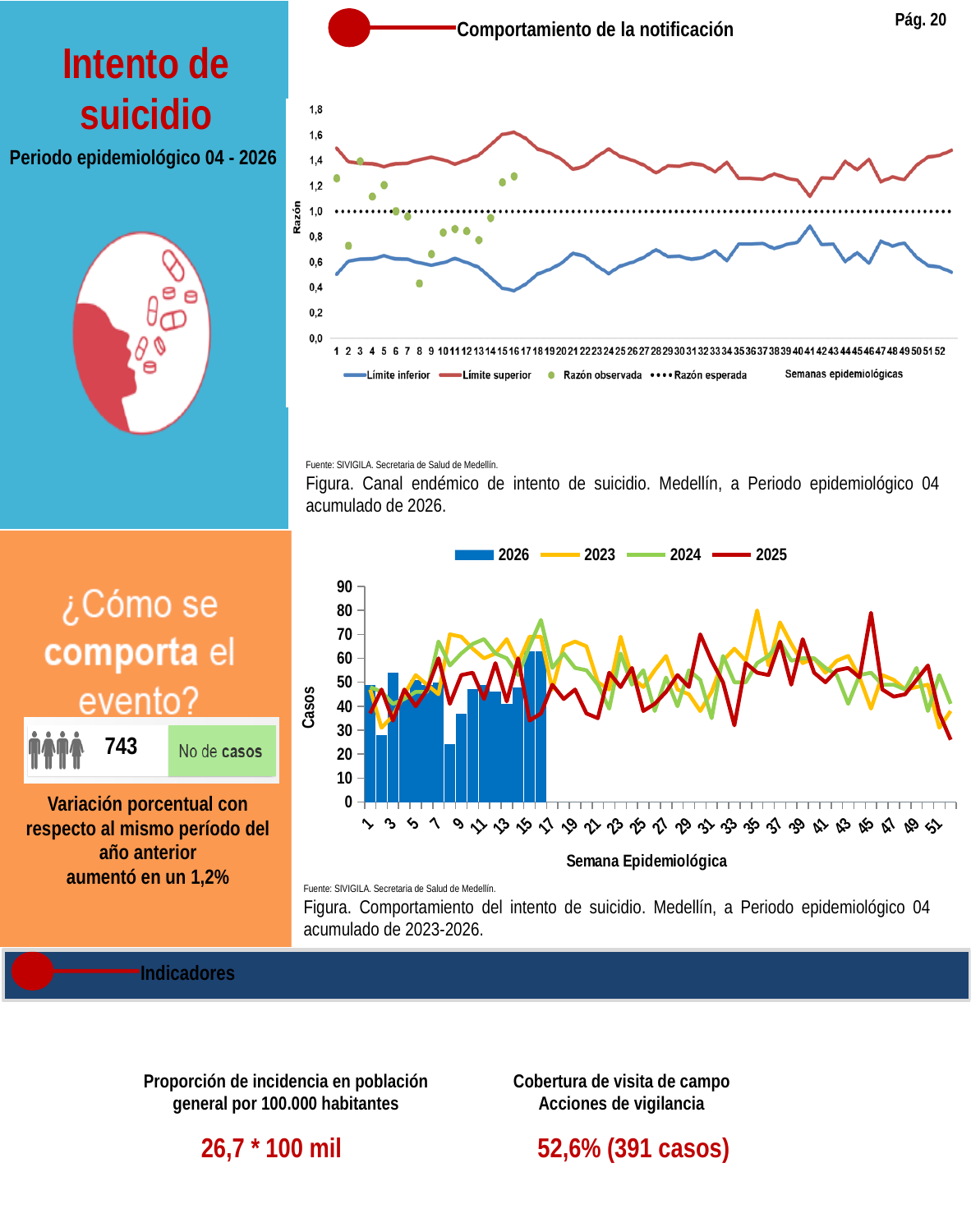
In the bottom chart (Comportamiento del intento de suicidio), at which week is the 2026 bar lowest? 8 In the top chart (Canal endémico), does the Límite inferior line rise or fall from week 41 to week 52? fall What kind of chart is the top chart (Canal endémico de intento de suicidio)? line chart How many epidemiological weeks are labelled on the x axis of the top chart (Canal endémico)? 52 In the top chart (Canal endémico), is the Límite superior value at week 16 greater or less than 1,4? greater In the top chart (Canal endémico), which is larger: the Razón observada at week 2 or at week 8? week 2 How many series does the legend of the bottom chart (Comportamiento del intento de suicidio) list? 4 In the bottom chart (Comportamiento del intento de suicidio), which year is plotted as bars rather than a line? 2026 How many entries does the legend of the top chart (Canal endémico) list? 4 In the top chart (Canal endémico), is the Razón observada value at week 8 greater or less than 0,6? less In the bottom chart (Comportamiento del intento de suicidio), is the 2023 value at week 35 greater or less than 70? greater